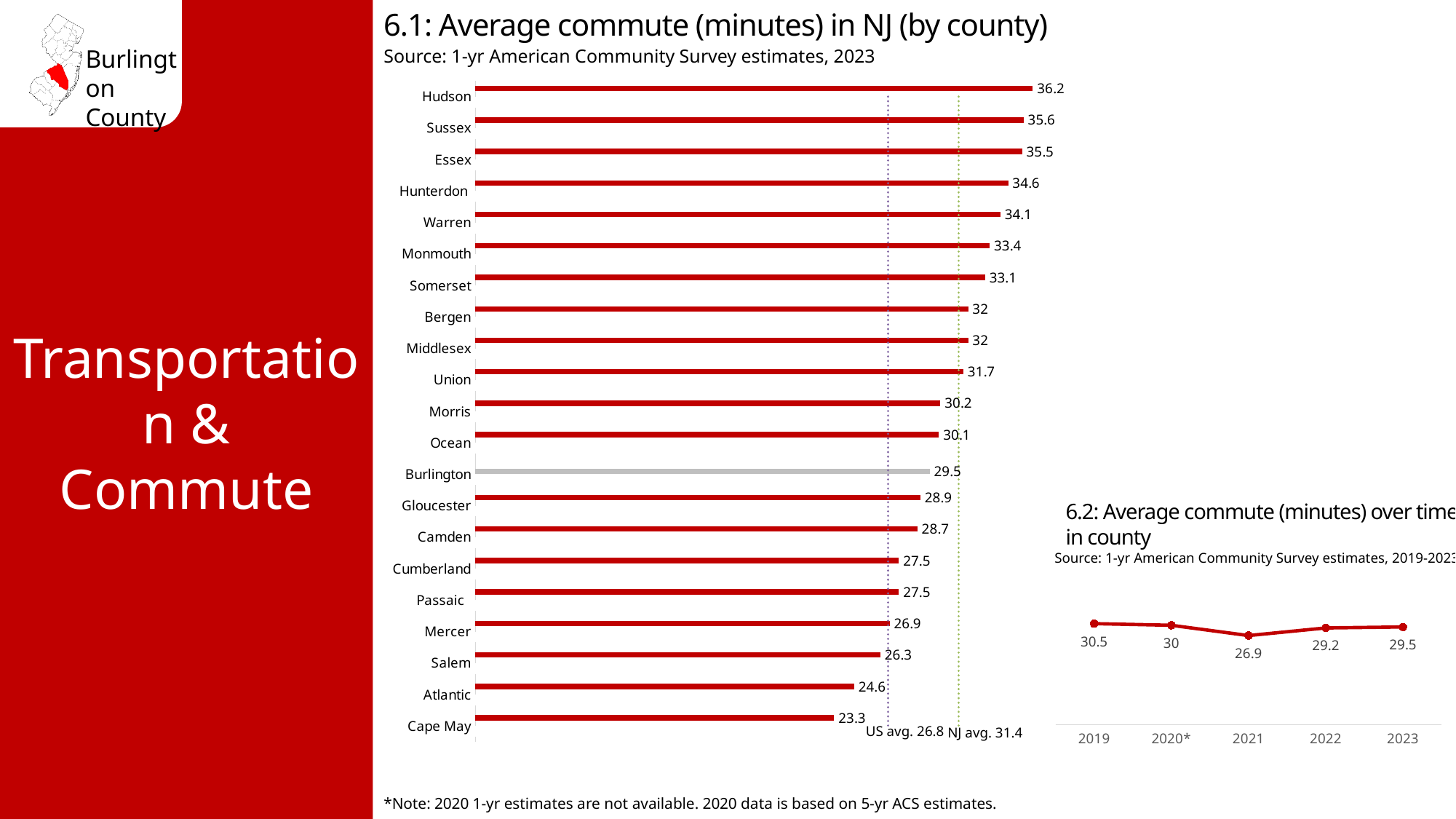
In chart 6.1 (Average commute in NJ by county), what is the average commute for Essex? 35.5 What kind of chart is chart 6.1 (Average commute in NJ by county)? Bar chart In chart 6.1 (Average commute in NJ by county), what is the difference between Hudson's and Cape May's average commute? 12.9 In chart 6.1 (Average commute in NJ by county), which has the longer average commute, Morris or Mercer? Morris In chart 6.2 (Average commute over time in county), which year has the highest value? 2019 In chart 6.1 (Average commute in NJ by county), how many counties are shown? 21 In chart 6.1 (Average commute in NJ by county), what NJ average value is marked by the dotted line? 31.4 In chart 6.2 (Average commute over time in county), what is the value for 2021? 26.9 In chart 6.2 (Average commute over time in county), how many data points are plotted? 5 In chart 6.1 (Average commute in NJ by county), what is the average commute for Burlington? 29.5 In chart 6.1 (Average commute in NJ by county), which county has the highest average commute? Hudson In chart 6.1 (Average commute in NJ by county), which county has the lowest average commute? Cape May